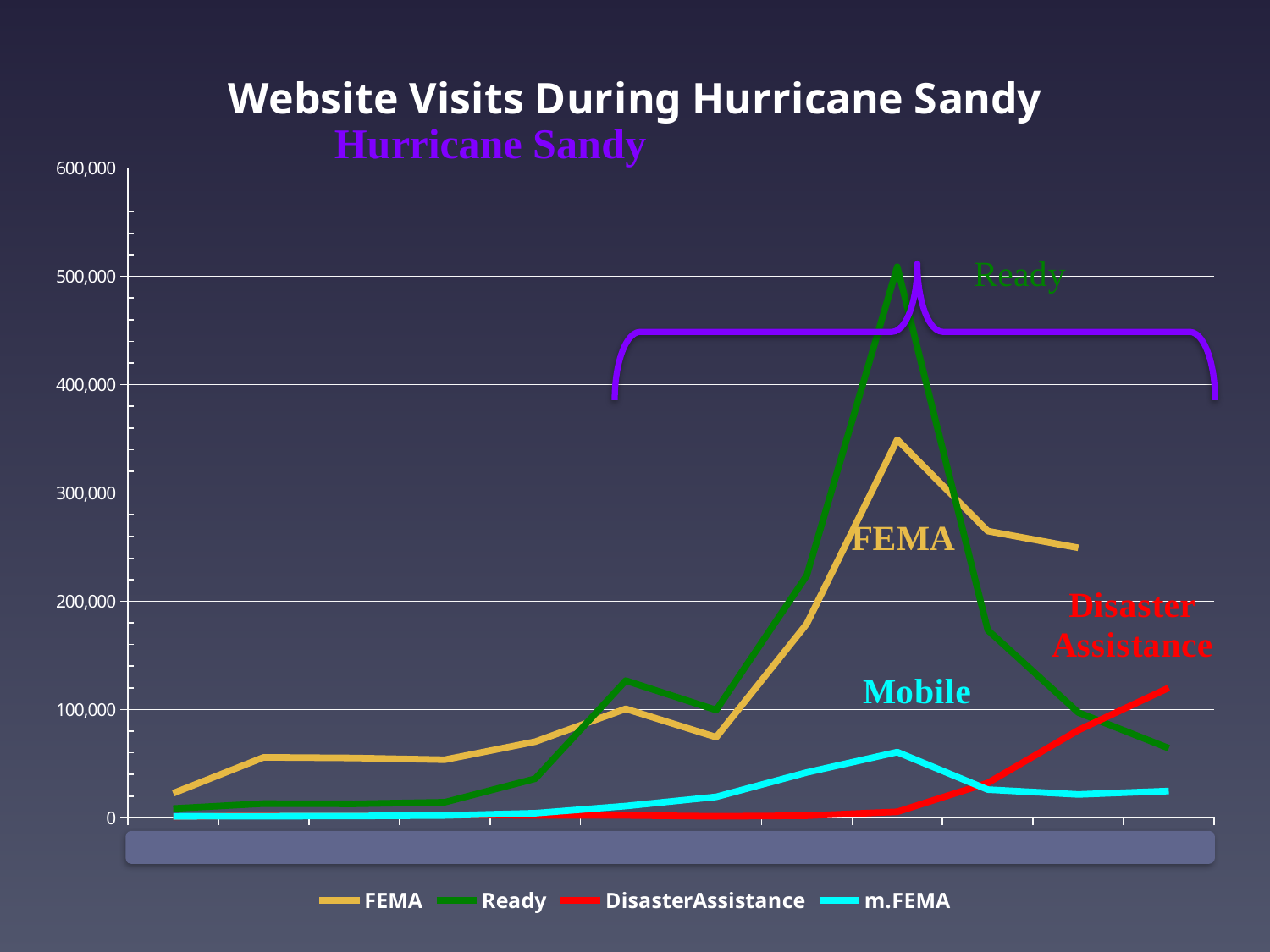
What kind of chart is shown on the slide? Line chart Does the DisasterAssistance series rise or fall toward the right end of the chart? Rise Is the peak value of the FEMA series greater or less than 300,000? greater What is the title of the chart? Website Visits During Hurricane Sandy Is the peak value of the m.FEMA series greater or less than 100,000? less Is the peak value of the Ready series greater or less than 400,000? greater How many series does the legend list? 4 What colour is the Ready line? Green Which series reaches the highest value on the chart? Ready At their peaks, which series is higher: Ready or FEMA? Ready